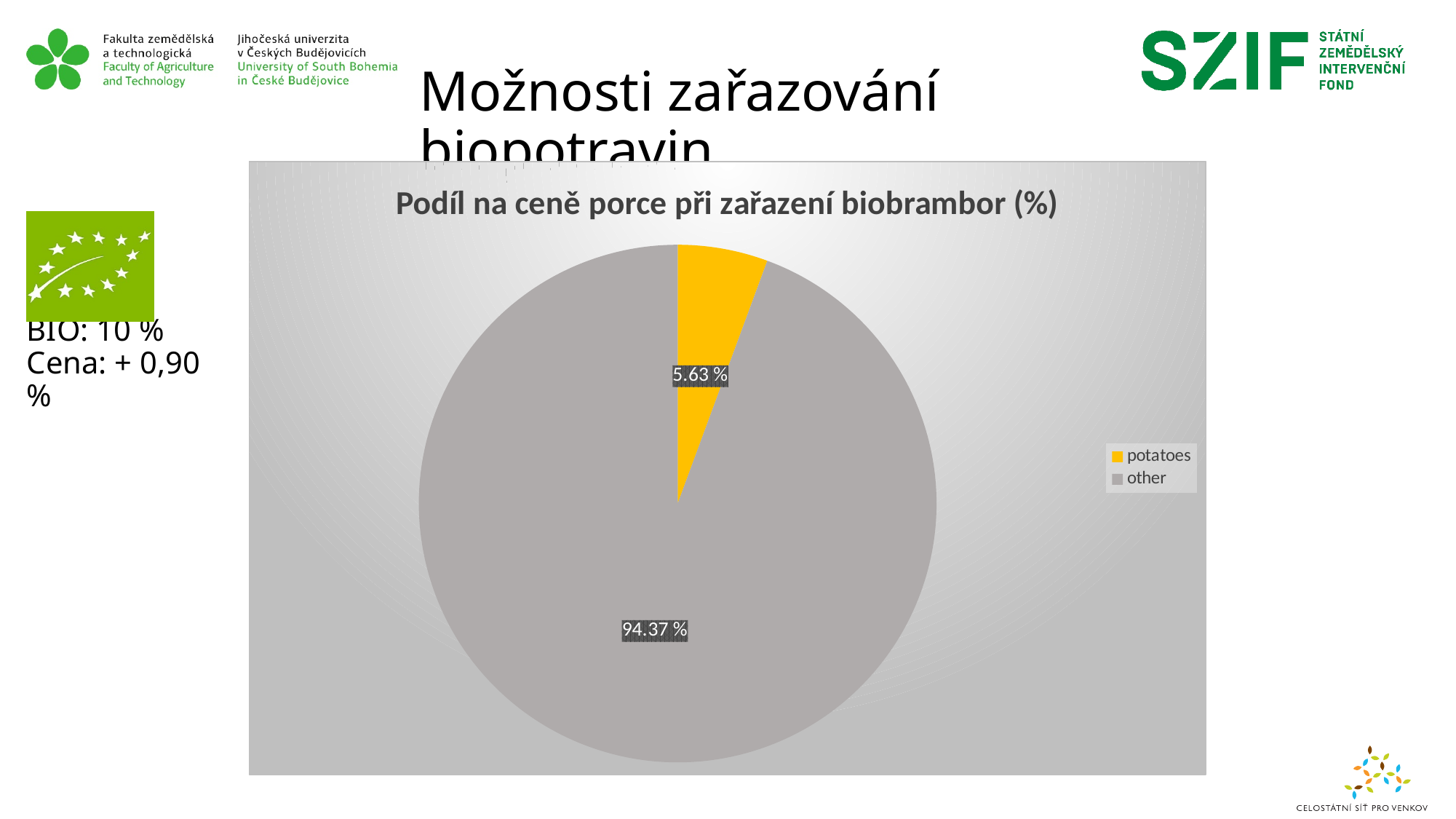
Which slice is the largest? other Which is larger, the potatoes slice or the other slice? other How many slices does the pie chart have? 2 What colour is the potatoes slice? yellow What is the difference between the other slice and the potatoes slice? 88.74 % How many entries does the legend list? 2 What is the value shown for other? 94.37 % What kind of chart is shown on the slide? pie chart What is the title of the chart? Podíl na ceně porce při zařazení biobrambor (%) Which slice is the smallest? potatoes What is the value shown for potatoes? 5.63 %